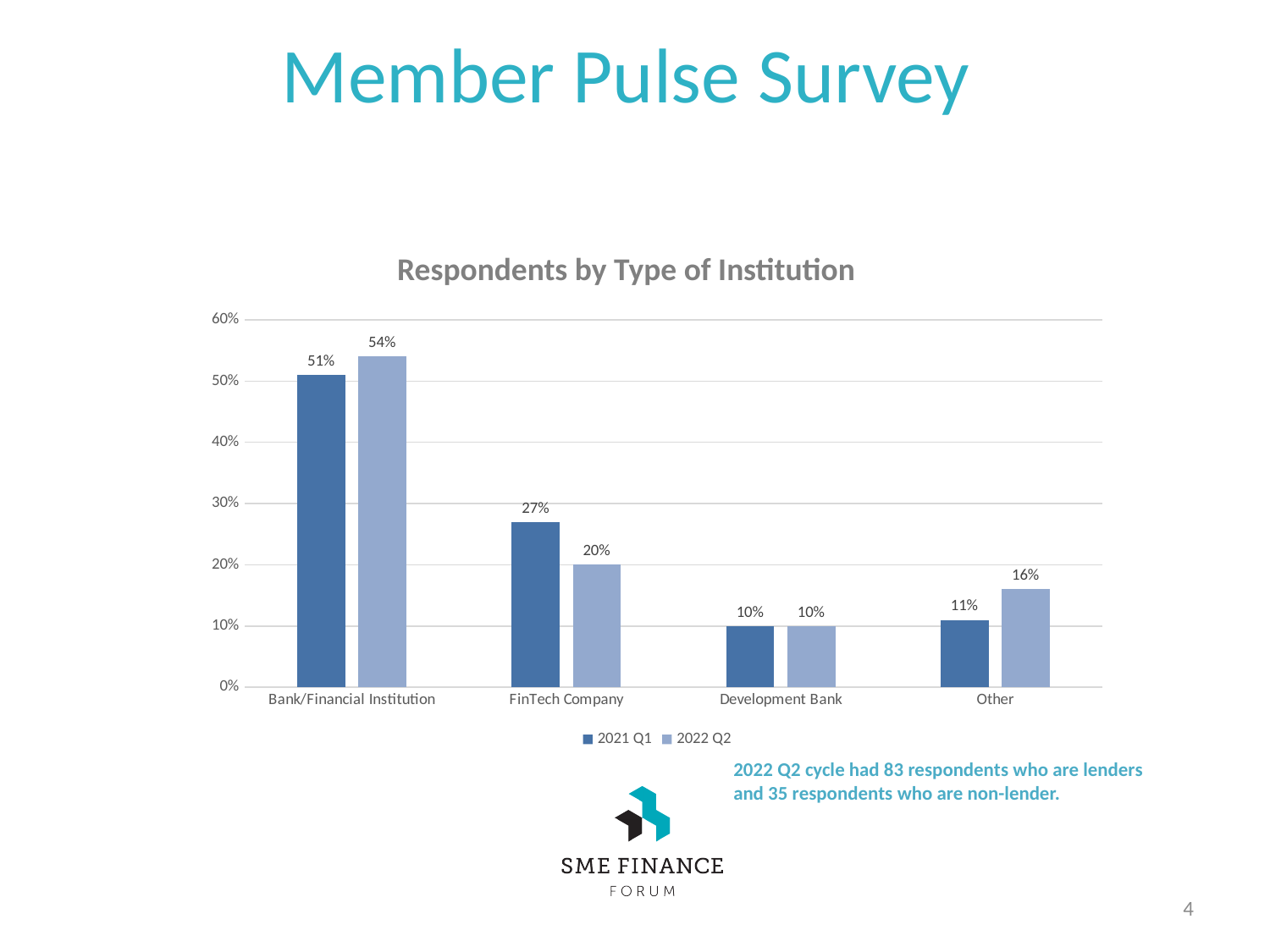
Which is larger for Other: the 2021 Q1 value or the 2022 Q2 value? 2022 Q2 How many series does the legend list? 2 What is the 2022 Q2 value for Other? 16% How many categories are shown on the x axis? 4 What is the 2021 Q1 value for FinTech Company? 27% What kind of chart is shown? Bar chart Which category has the highest 2021 Q1 value? Bank/Financial Institution What is the title of the chart? Respondents by Type of Institution Which category has the lowest 2022 Q2 value? Development Bank What is the difference between the 2021 Q1 and 2022 Q2 values for FinTech Company? 7% What are the two series listed in the legend? 2021 Q1 and 2022 Q2 What is the 2022 Q2 value for Bank/Financial Institution? 54%